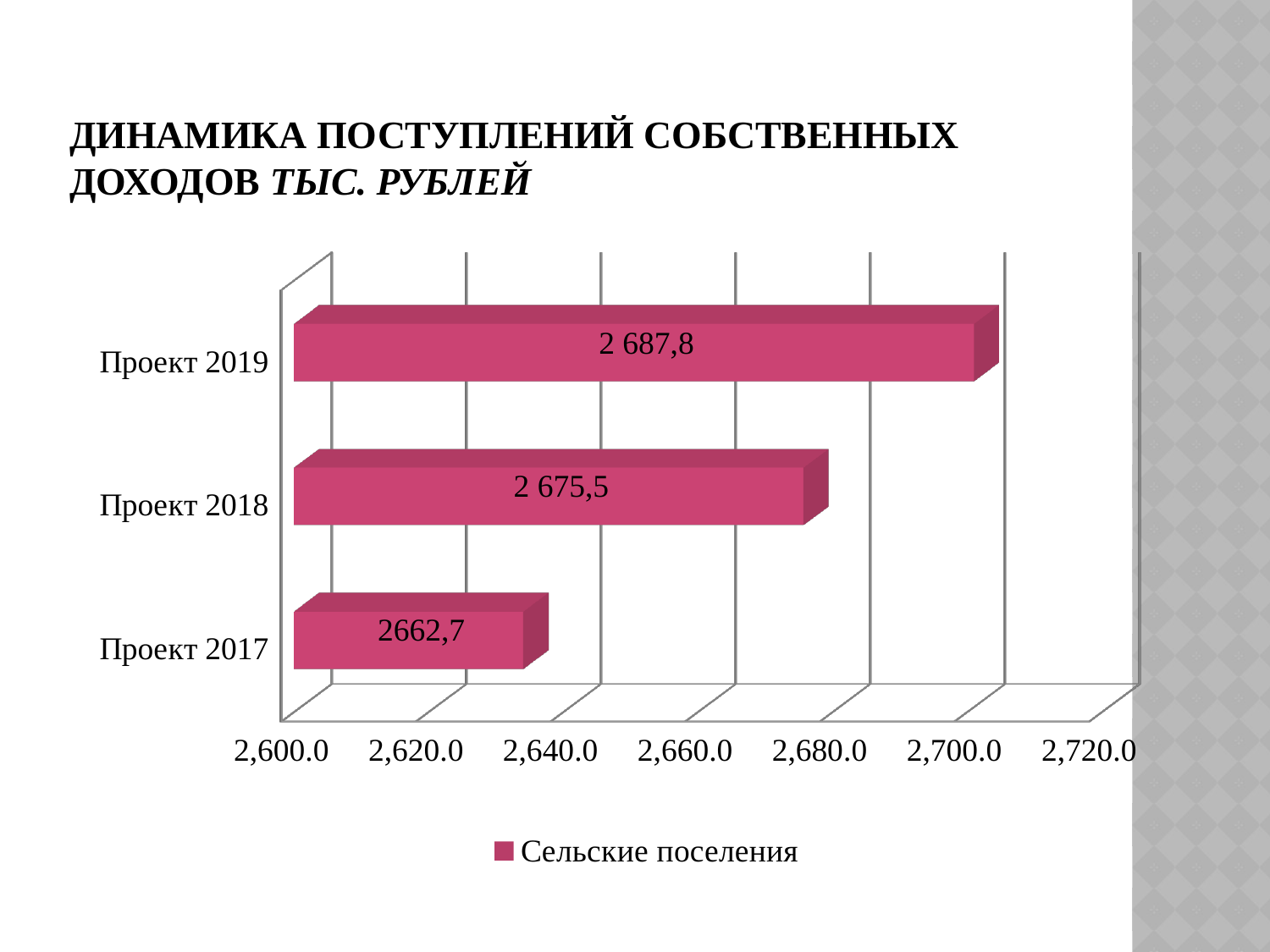
Which category has the lowest value? Проект 2017 Is the value for Проект 2017 greater or less than 2,680.0? less Which category has the highest value? Проект 2019 What is the value for Проект 2017? 2662,7 Which is larger, the value for Проект 2018 or Проект 2017? Проект 2018 What is the difference between the values for Проект 2019 and Проект 2017? 25,1 What is the difference between the values for Проект 2019 and Проект 2018? 12,3 What kind of chart is shown on the slide? bar chart How many categories are shown in the chart? 3 What series name does the legend list? Сельские поселения What is the value for Проект 2018? 2 675,5 What is the value for Проект 2019? 2 687,8